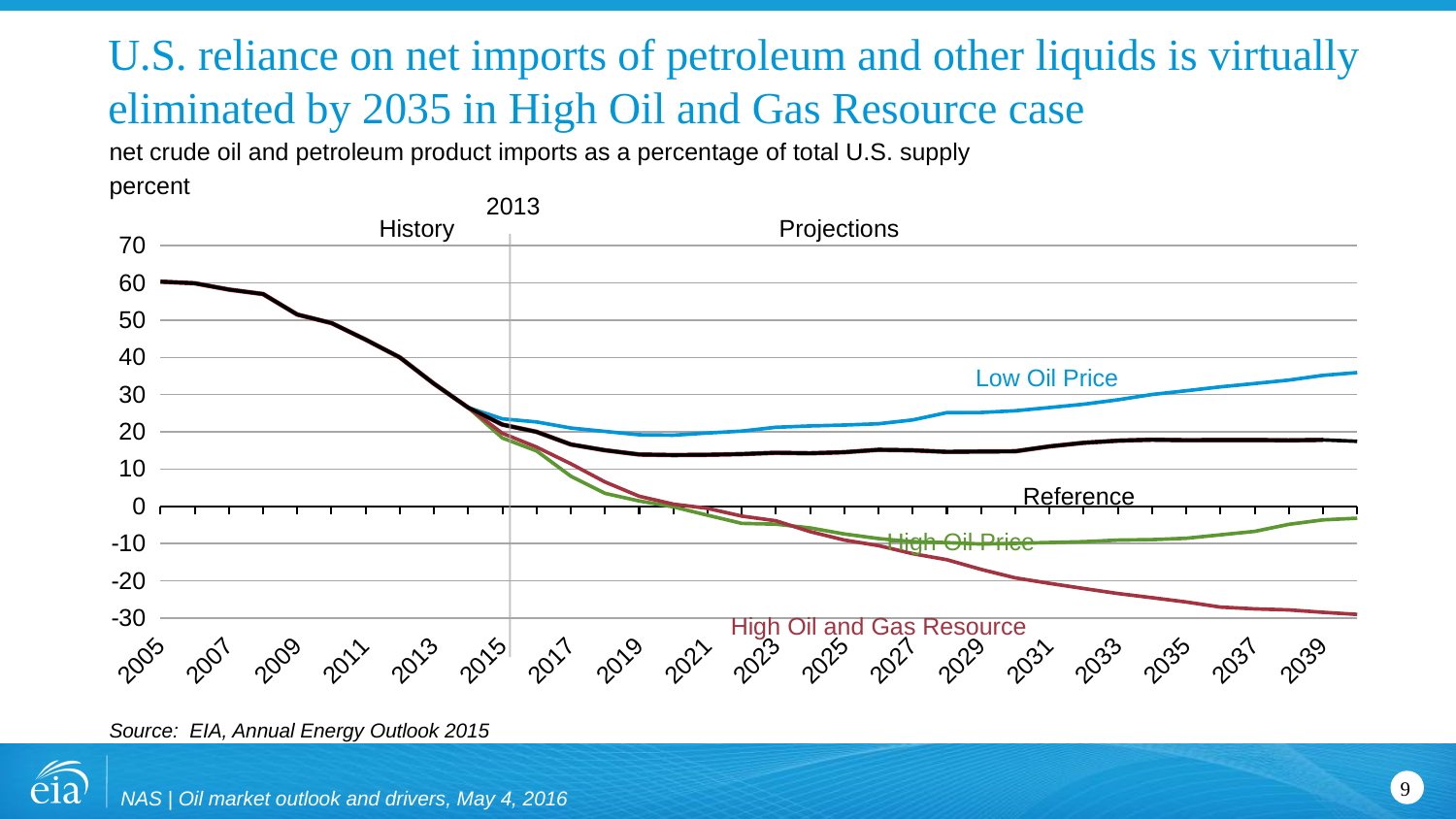
How many projection series are labeled on the chart? 4 Does the historical line rise or fall between 2005 and 2015? fall Which year marks the boundary between History and Projections on the chart? 2013 In 2039, which is larger: the Low Oil Price value or the Reference value? Low Oil Price Which series has the lowest value in 2039? High Oil and Gas Resource Is the historical value in 2005 greater or less than 50? greater Which series has the highest value in 2039? Low Oil Price Does the Low Oil Price line rise or fall between 2019 and 2039? rise Is the value for High Oil and Gas Resource in 2039 greater or less than -20? less Is the value for Reference in 2039 greater or less than 20? less What kind of chart is shown on the slide? line chart